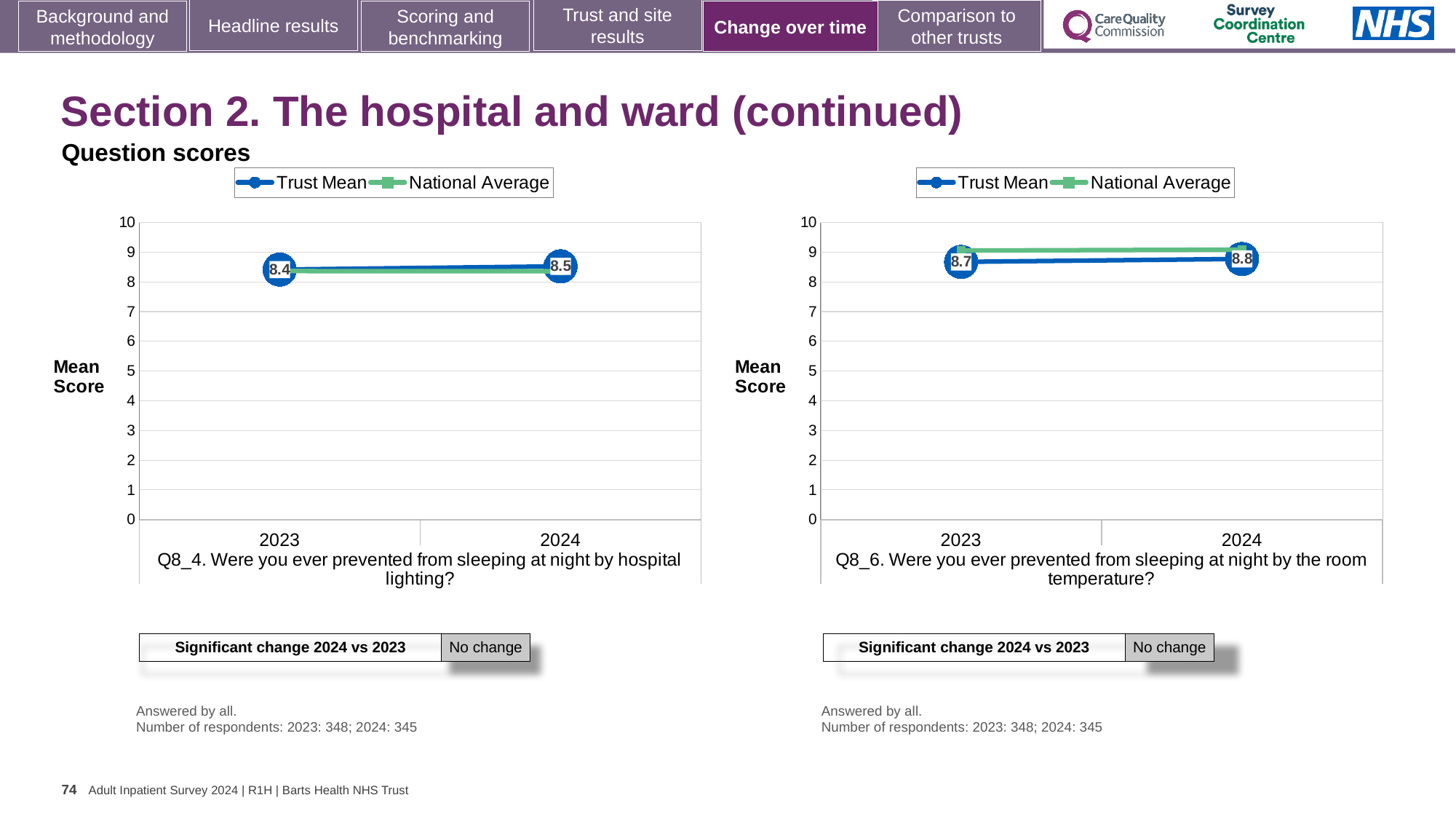
In the right chart (Q8_6), which is higher in 2024, the Trust Mean or the National Average? National Average In the right chart (Q8_6), does the Trust Mean rise or fall from 2023 to 2024? rise In the right chart (Q8_6), is the National Average for 2024 greater or less than 8? greater In the right chart (Q8_6), what is the Trust Mean score for 2023? 8.7 How many years are shown on the x axis of the left chart (Q8_4)? 2 How many series does the legend of the right chart (Q8_6) list? 2 In the left chart (Q8_4), what is the Trust Mean score for 2024? 8.5 In the left chart (Q8_4), by how much did the Trust Mean change from 2023 to 2024? 0.1 In the right chart (Q8_6), what is the difference between the Trust Mean in 2024 and in 2023? 0.1 In the left chart (Q8_4), what is the Trust Mean score for 2023? 8.4 What kind of chart is the left chart (Q8_4)? line chart In the right chart (Q8_6), what is the Trust Mean score for 2024? 8.8